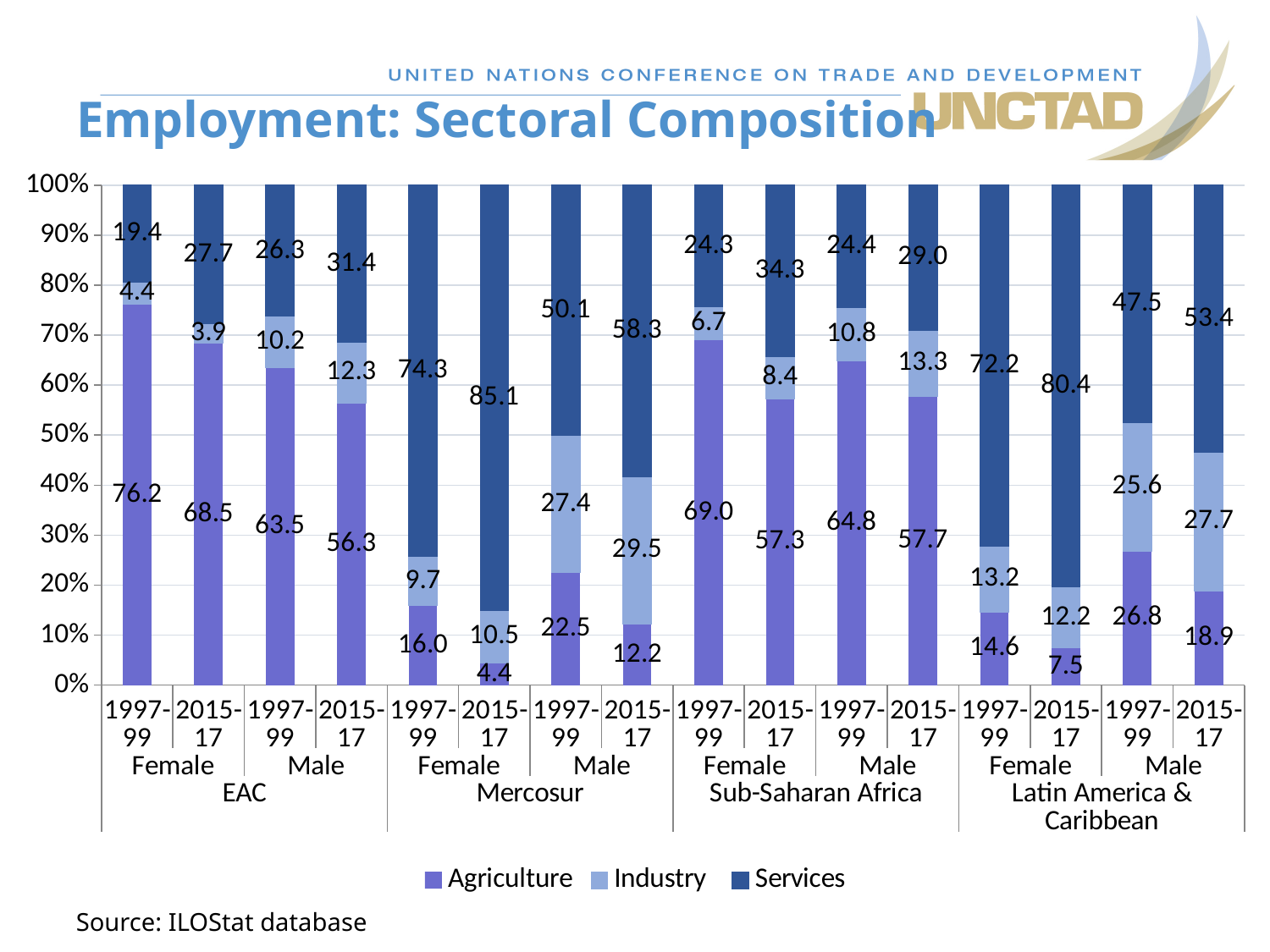
What is the source cited for the chart? ILOStat database Does the Agriculture value for Latin America & Caribbean Female fall or rise from 1997-99 to 2015-17? Fall Which is larger, the Services value for EAC Male in 2015-17 or for Sub-Saharan Africa Male in 2015-17? EAC Male 2015-17 What is the Agriculture value for EAC Female in 1997-99? 76.2 What is the Industry value for Latin America & Caribbean Male in 2015-17? 27.7 What kind of chart is shown on the slide? Stacked bar chart How many series does the legend list? 3 What is the Services value for Mercosur Female in 2015-17? 85.1 Which bar has the highest Services value? Mercosur Female 2015-17 Which bar has the lowest Agriculture value? Mercosur Female 2015-17 How many bars are plotted in the chart? 16 What is the difference between the Agriculture values for Sub-Saharan Africa Female in 1997-99 and 2015-17? 11.7